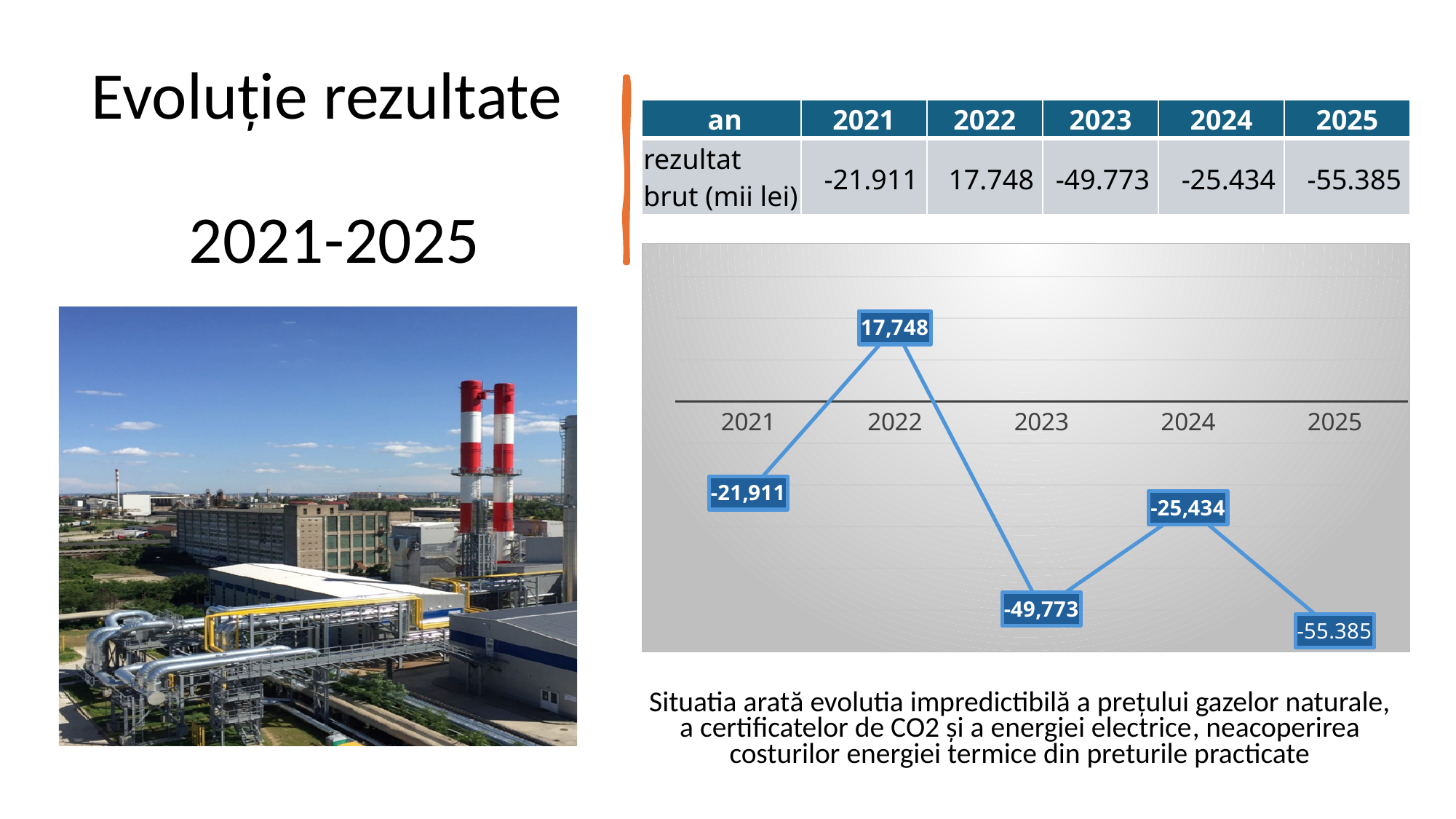
What is the value plotted for 2024 on the chart? -25,434 How many years are plotted on the chart? 5 Which is larger on the chart, the value for 2021 or the value for 2023? 2021 What is the value plotted for 2025 on the chart? -55.385 What is the difference between the values for 2024 and 2023 on the chart? 24,339 What is the value plotted for 2023 on the chart? -49,773 What is the value plotted for 2022 on the chart? 17,748 Does the value rise or fall from 2022 to 2023 on the chart? fall Which year has the lowest value on the chart? 2025 Which year has the highest value on the chart? 2022 What is the value plotted for 2021 on the chart? -21,911 What kind of chart is shown on the slide? line chart